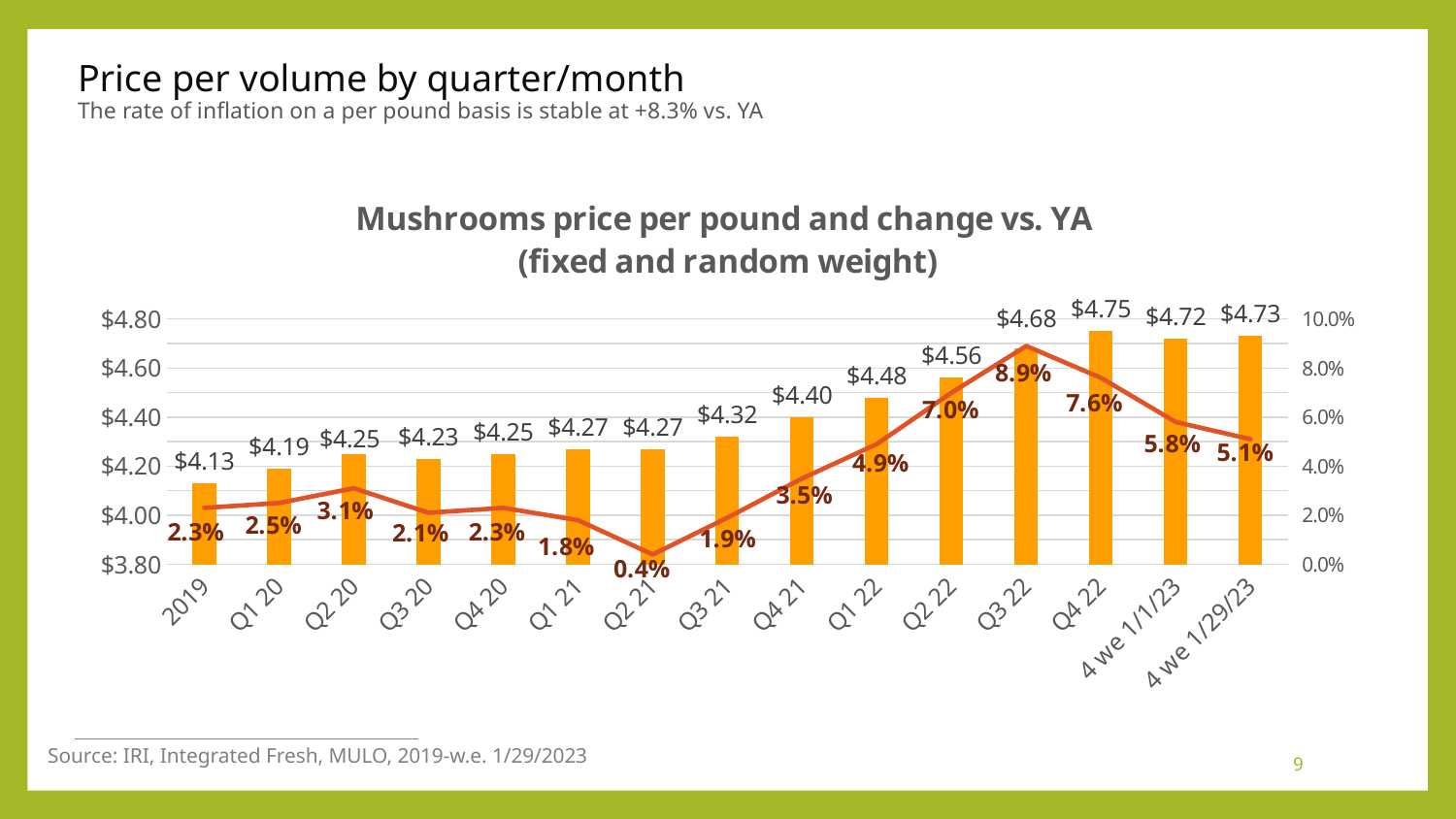
Which period has the highest price per pound? Q4 22 What kind of chart is this? Combination bar and line chart What is the price per pound for the 4 we 1/29/23 period? $4.73 What is the difference in price per pound between Q4 22 and 2019? $0.62 How many periods are shown on the x axis? 15 What is the change vs. YA shown for Q2 21? 0.4% Which period has the lowest change vs. YA? Q2 21 Which period has the highest change vs. YA? Q3 22 Which period has the lowest price per pound? 2019 What is the price per pound for Q3 22? $4.68 What is the change vs. YA shown for Q4 22? 7.6% Which is higher, the price per pound in Q1 22 or in Q2 22? Q2 22